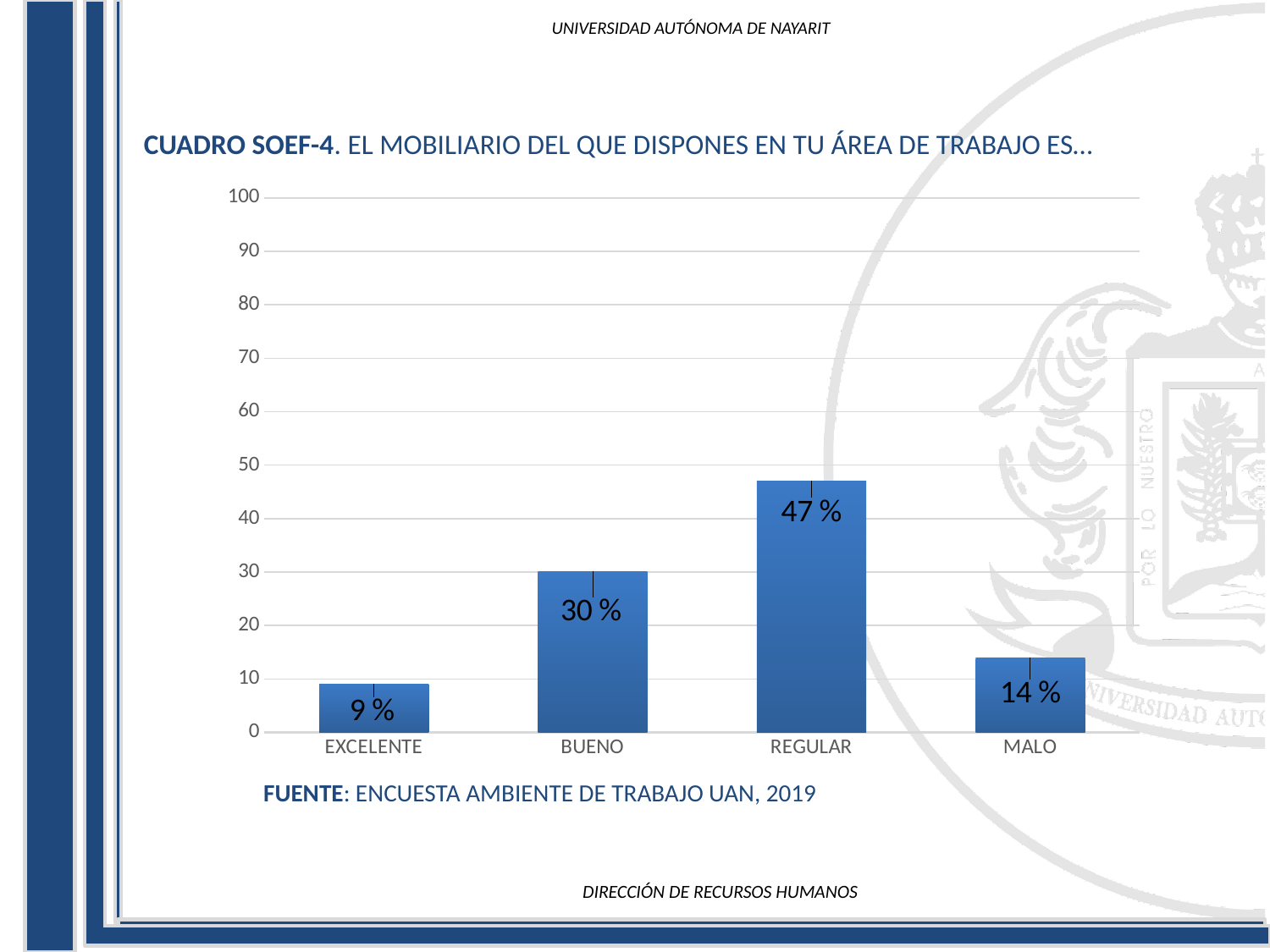
What is the difference between the values for REGULAR and BUENO? 17 % Which category has the lowest value? EXCELENTE What is the value for MALO? 14 % How many categories are shown on the x axis? 4 What is the value for REGULAR? 47 % Is the value for BUENO greater or less than 20? greater What kind of chart is shown on the slide? bar chart What is the source cited below the chart? ENCUESTA AMBIENTE DE TRABAJO UAN, 2019 What is the value for BUENO? 30 % Which category has the highest value? REGULAR Which is larger, the value for MALO or the value for EXCELENTE? MALO What is the value for EXCELENTE? 9 %